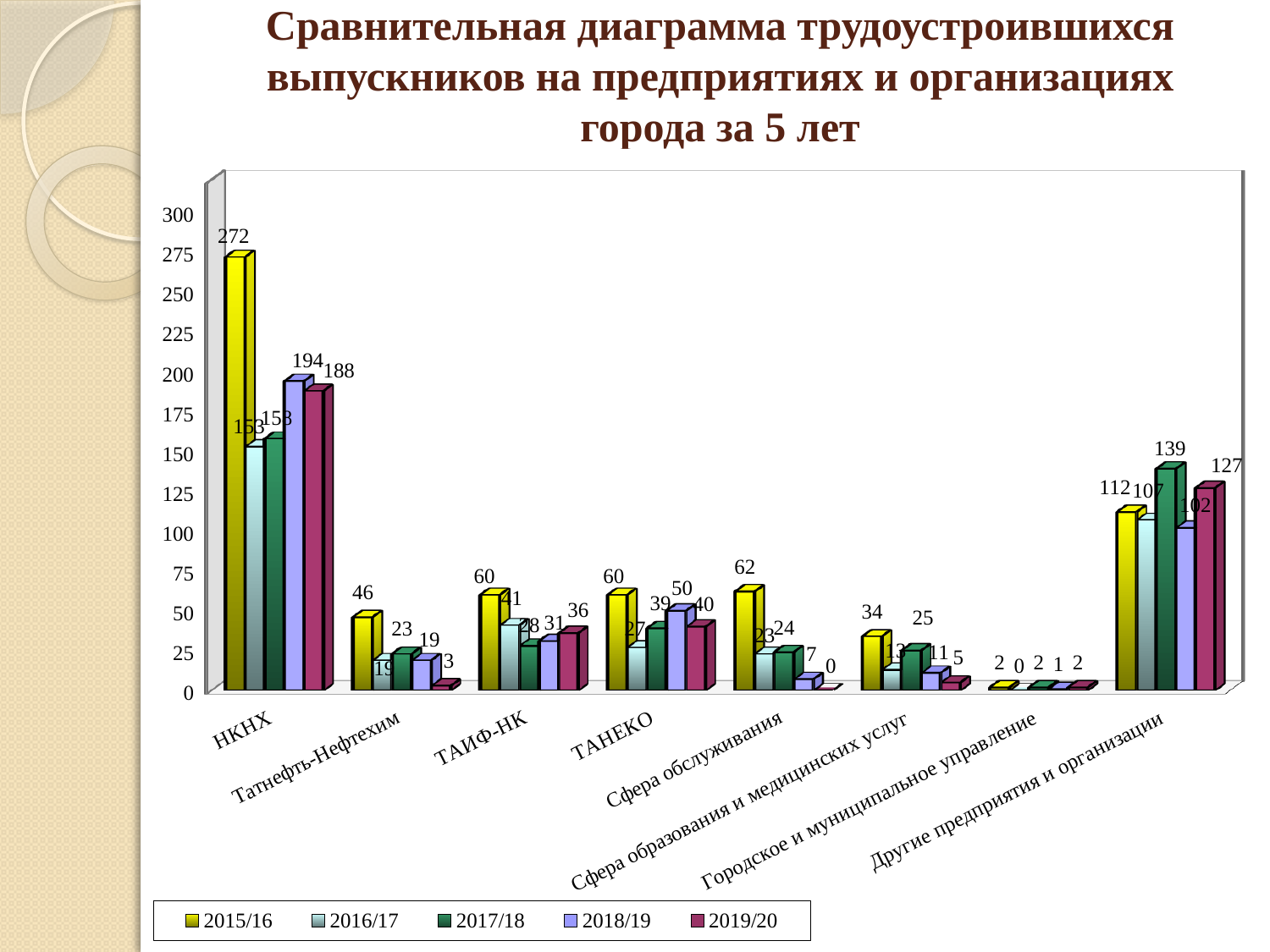
Which series is shown in yellow in the legend? 2015/16 What is the value for НКНХ in the 2015/16 series? 272 How many series does the legend list? 5 What kind of chart is shown on the slide? Bar chart What is the value for Другие предприятия и организации in the 2017/18 series? 139 Which category has the highest value in the 2015/16 series? НКНХ What is the difference between the 2015/16 and 2019/20 values for НКНХ? 84 What is the value for ТАНЕКО in the 2018/19 series? 50 Which is larger for Другие предприятия и организации: the 2015/16 value or the 2019/20 value? 2019/20 Which category has the lowest value in the 2019/20 series? Сфера обслуживания What is the value for Сфера обслуживания in the 2019/20 series? 0 How many categories are shown on the x axis? 8